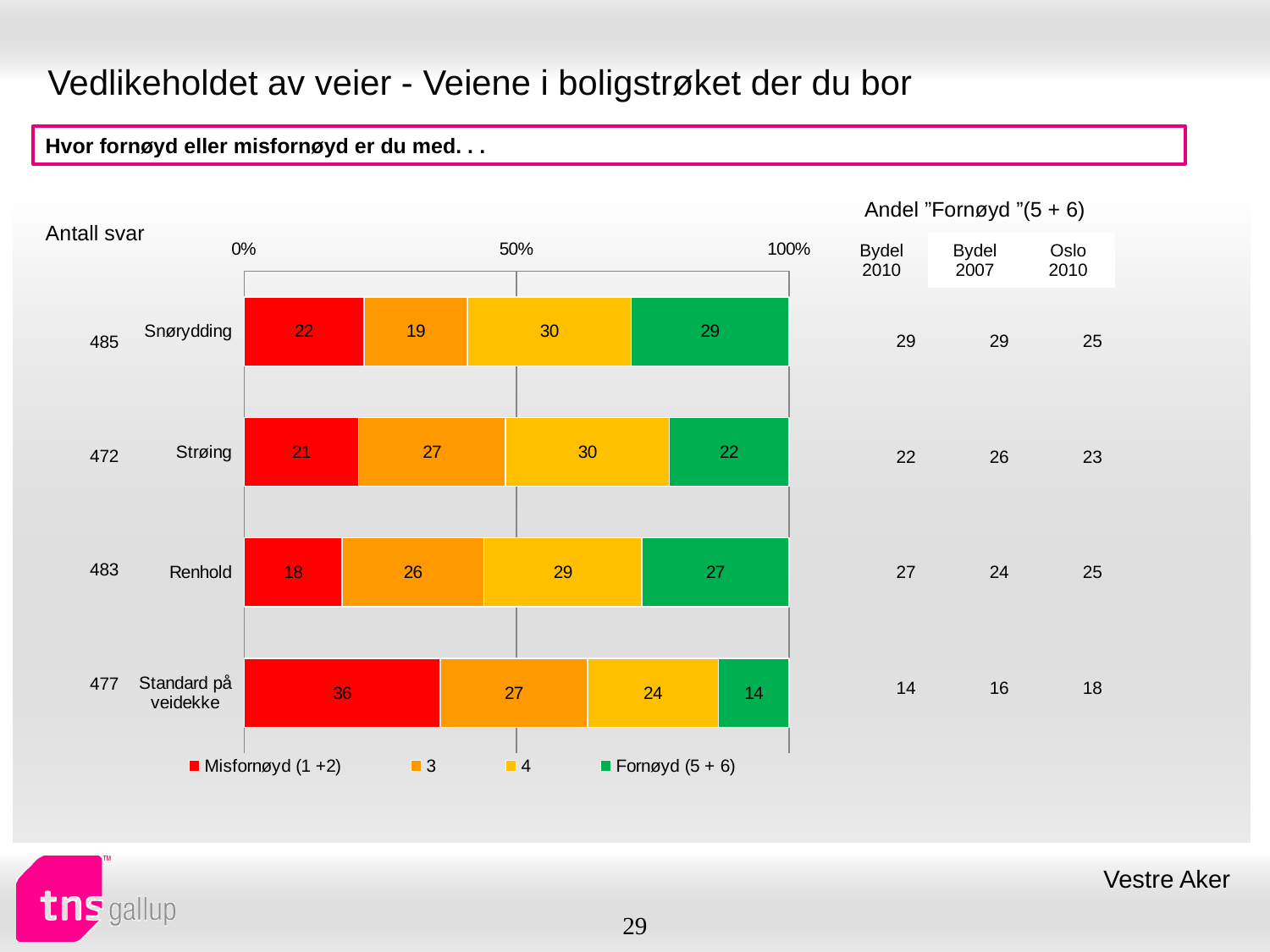
Which is larger: the Fornøyd (5 + 6) value for Renhold or for Strøing? Renhold What is the difference between the Misfornøyd (1 +2) values for Standard på veidekke and Renhold? 18 What is the value of the Fornøyd (5 + 6) segment for Snørydding? 29 How many categories are plotted in the chart? 4 Which legend entry is shown in green? Fornøyd (5 + 6) Which category has the lowest Fornøyd (5 + 6) value? Standard på veidekke What is the value of the '4' segment for Renhold? 29 What kind of chart is shown on the slide? stacked bar chart How many series does the legend list? 4 What is the value of the '3' segment for Strøing? 27 What is the value of the Misfornøyd (1 +2) segment for Standard på veidekke? 36 Which category has the highest Misfornøyd (1 +2) value? Standard på veidekke